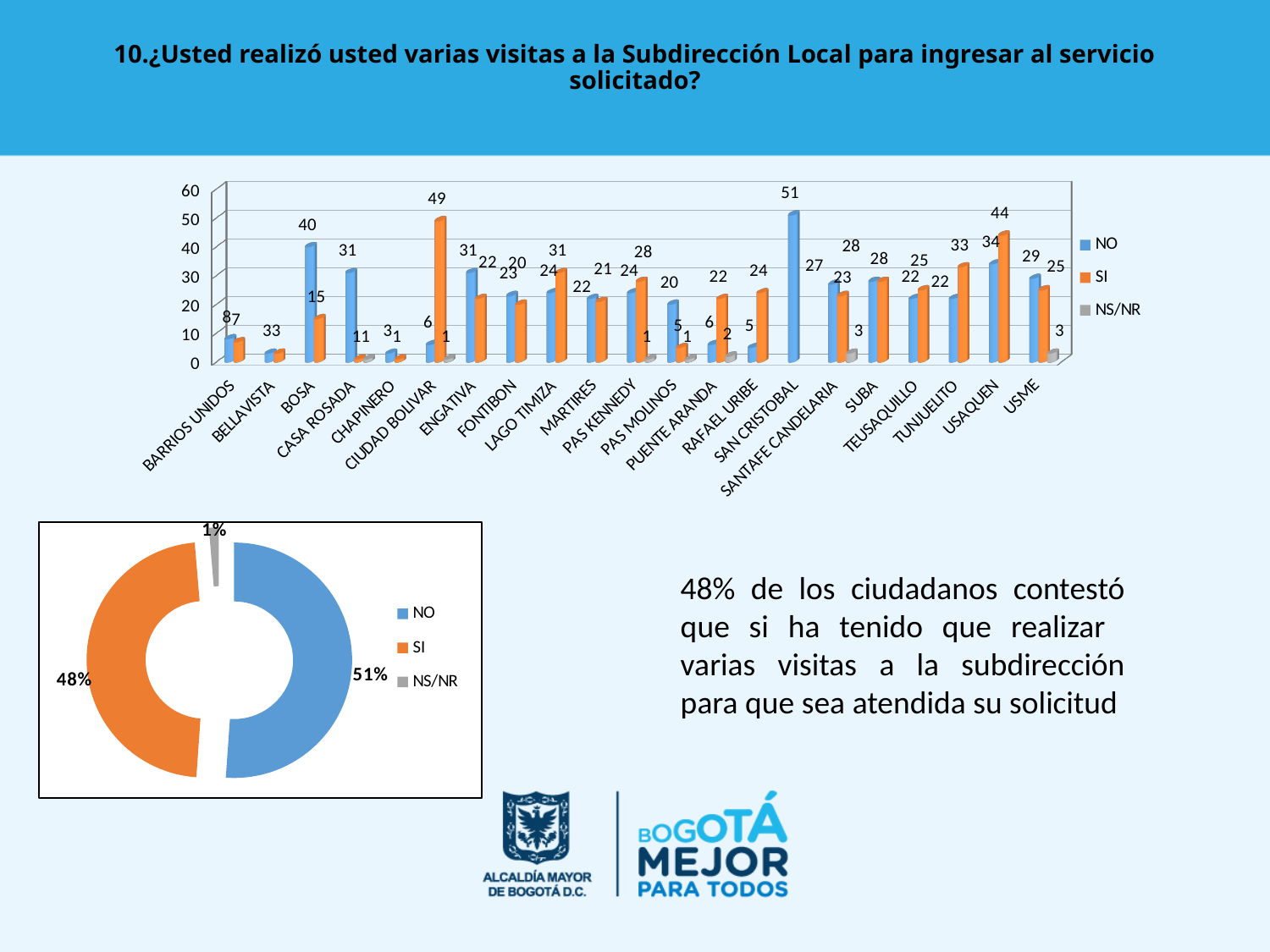
In the bar chart, what is the SI value for CIUDAD BOLIVAR? 49 In the bar chart, what is the NS/NR value for USME? 3 In the bar chart, which category has the highest SI value? CIUDAD BOLIVAR In the bar chart, how many categories are shown on the x axis? 21 What type of chart is the upper chart on the slide? Bar chart In the bar chart, which is larger for BOSA, the NO value or the SI value? NO In the bar chart, what is the difference between the SI and NO values for USAQUEN? 10 In the doughnut chart, what share of respondents answered NO? 51% In the bar chart, how many series does the legend list? 3 In the doughnut chart, what share of respondents answered SI? 48% In the bar chart, what is the NO value for BOSA? 40 In the bar chart, which category has the highest NO value? SAN CRISTOBAL